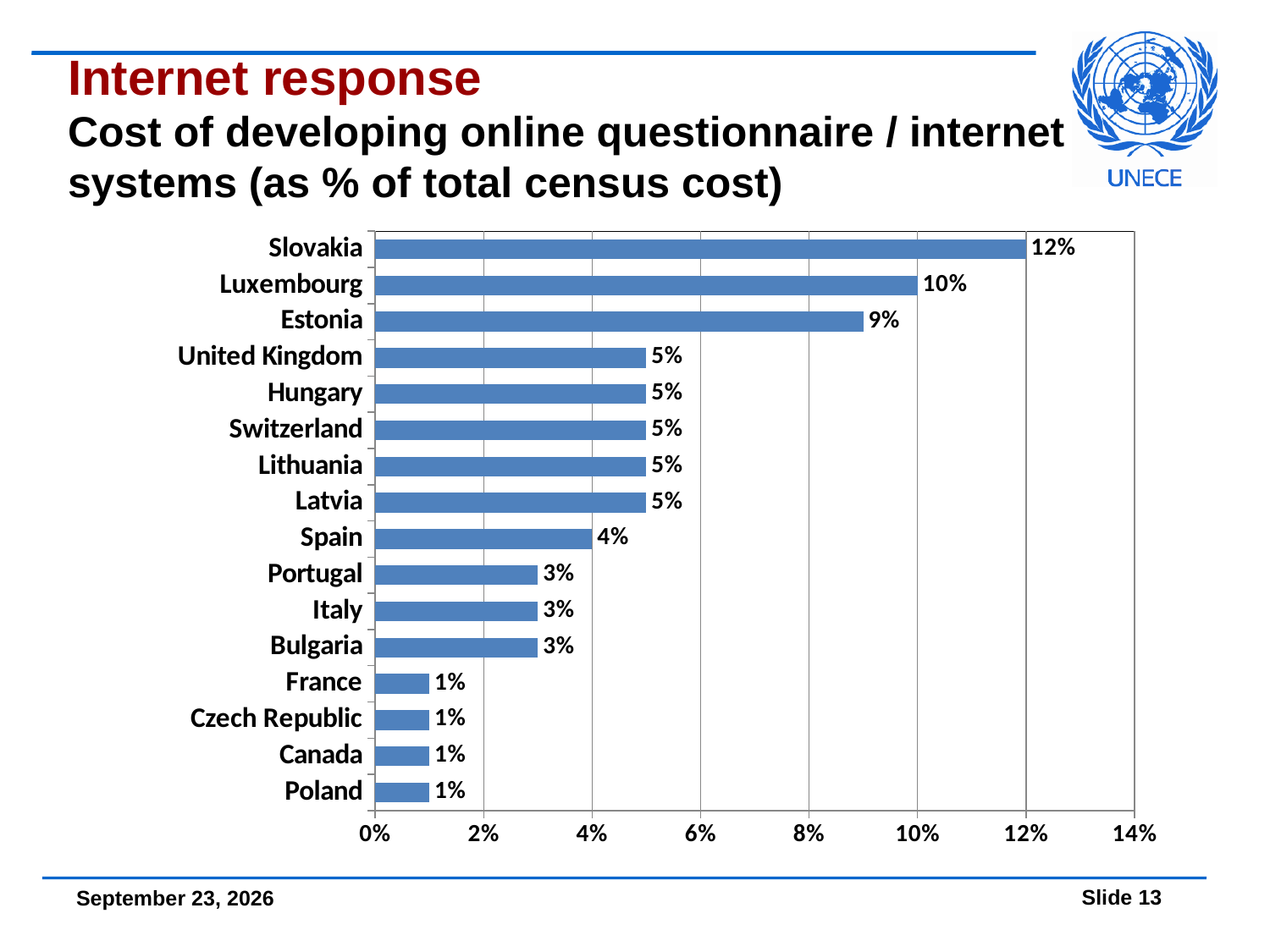
What is the value for Slovakia? 12% What is the value for Spain? 4% What kind of chart is shown on the slide? Bar chart What is the value for Estonia? 9% Which country has the highest value? Slovakia What is the maximum value shown on the horizontal axis? 14% What is the difference between the values for Slovakia and Luxembourg? 2% Which is larger, the value for Luxembourg or the value for United Kingdom? Luxembourg How many countries are shown in the chart? 16 What is the value for Portugal? 3% What is the difference between the values for Estonia and Spain? 5% Is the value for Estonia greater or less than 8%? greater